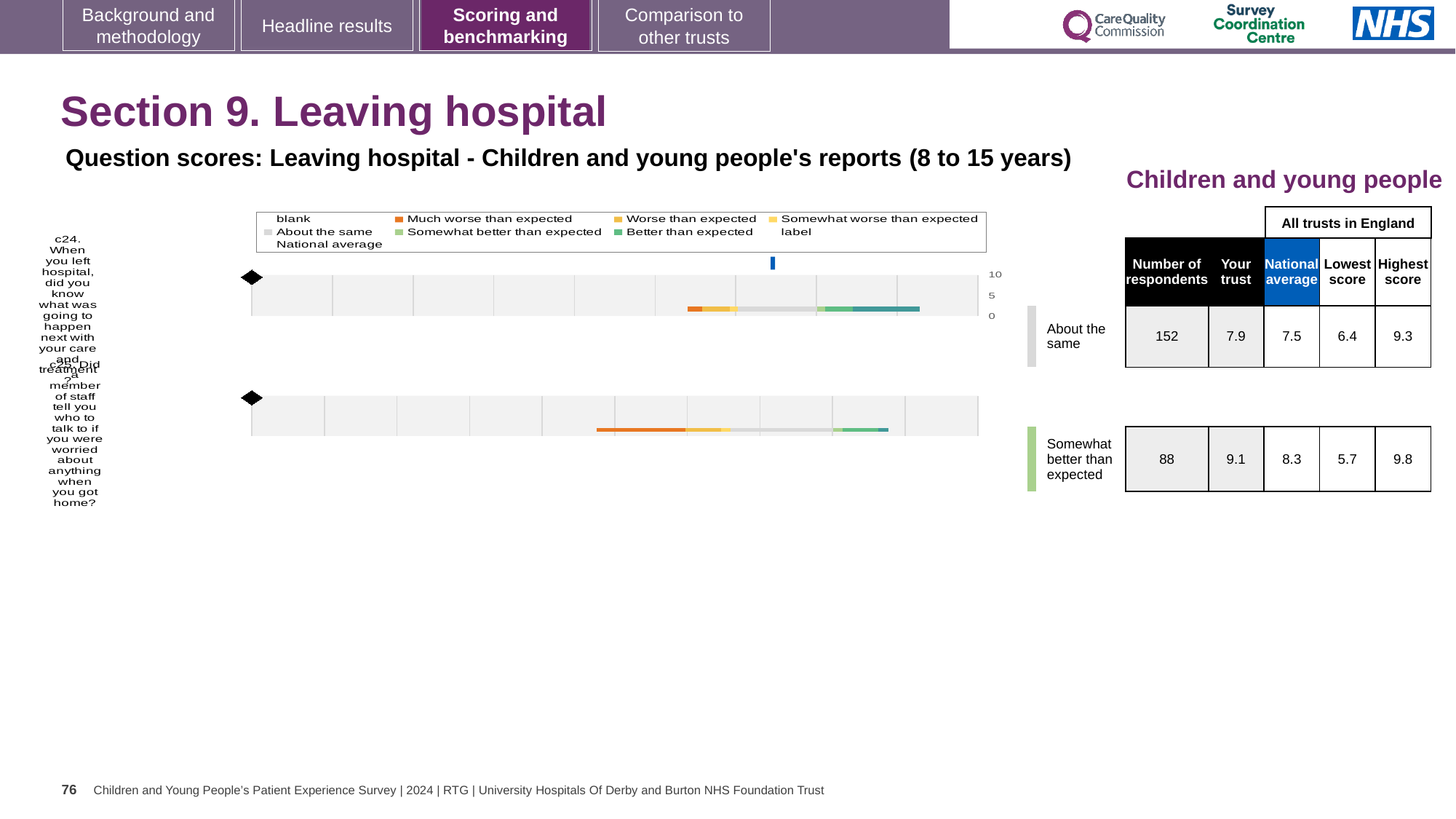
What is the lowest score among all trusts in England for question c24? 6.4 What is the difference between the 'Your trust' score and the national average for question c25? 0.8 How many more respondents answered question c24 than question c25? 64 What kind of chart is used to show the question scores for Leaving hospital? bar chart How many respondents answered question c24? 152 Which benchmarking category is question c24 placed in? About the same What is the national average score for question c25 (Did a member of staff tell you who to talk to if you were worried about anything when you got home?)? 8.3 What is the 'Your trust' score for question c24 (When you left hospital, did you know what was going to happen next with your care and treatment?)? 7.9 How many survey questions are plotted in the Leaving hospital chart? 2 Which benchmarking category is question c25 placed in? Somewhat better than expected Which question has the higher 'Your trust' score, c24 or c25? c25 What is the highest score among all trusts in England for question c25? 9.8